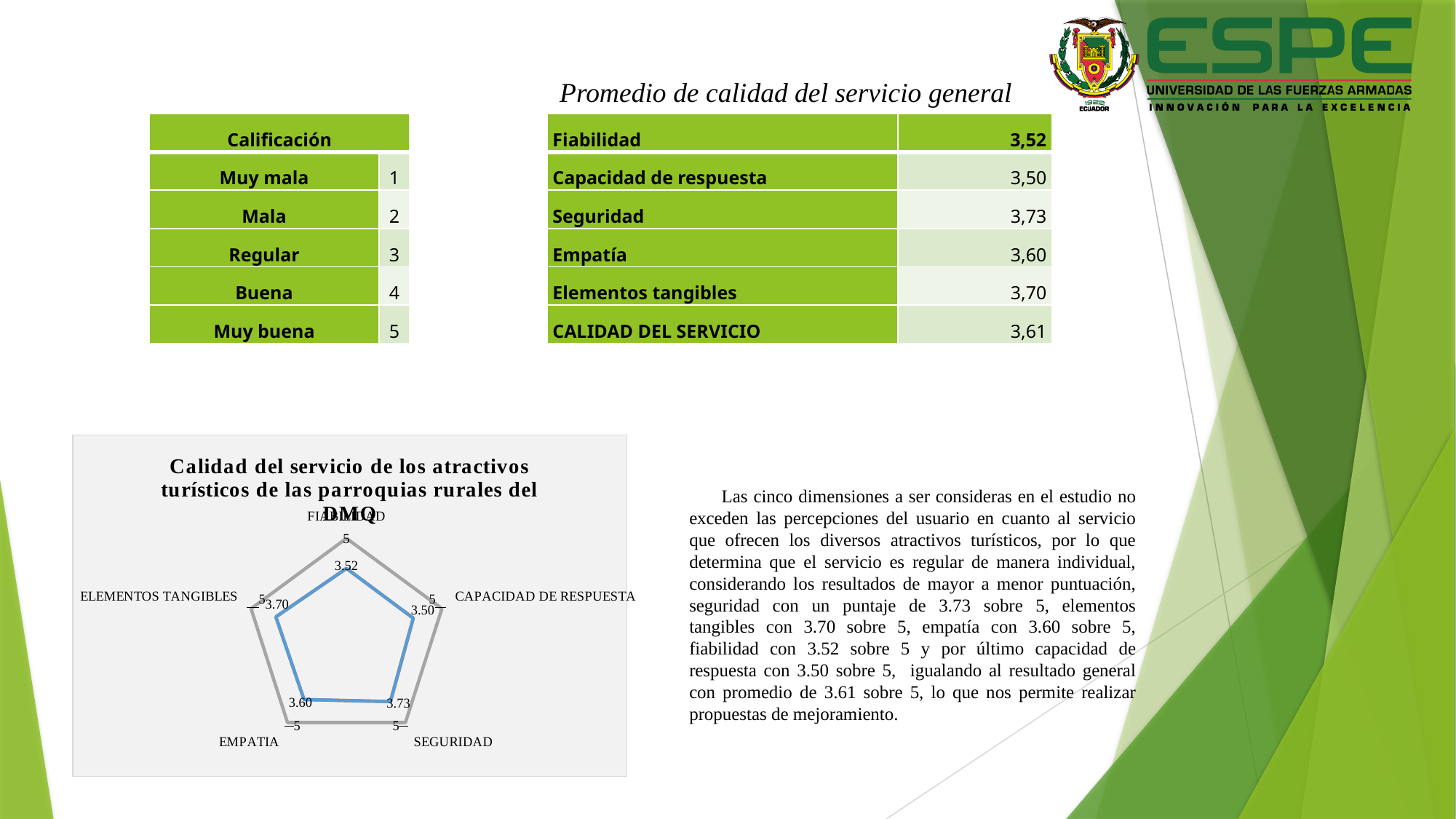
What is the title of the radar chart? Calidad del servicio de los atractivos turísticos de las parroquias rurales del DMQ What is the value for EMPATIA in the radar chart? 3.60 What is the value for FIABILIDAD in the radar chart? 3.52 What is the value for CAPACIDAD DE RESPUESTA in the radar chart? 3.50 How many dimensions (axes) does the radar chart have? 5 What kind of chart is shown on the slide? Radar chart Which dimension has the highest value in the radar chart? SEGURIDAD What is the value for ELEMENTOS TANGIBLES in the radar chart? 3.70 Which has a larger value in the radar chart, ELEMENTOS TANGIBLES or EMPATIA? ELEMENTOS TANGIBLES Which dimension has the lowest value in the radar chart? CAPACIDAD DE RESPUESTA What is the value for SEGURIDAD in the radar chart? 3.73 What is the difference between the values for SEGURIDAD and CAPACIDAD DE RESPUESTA in the radar chart? 0.23